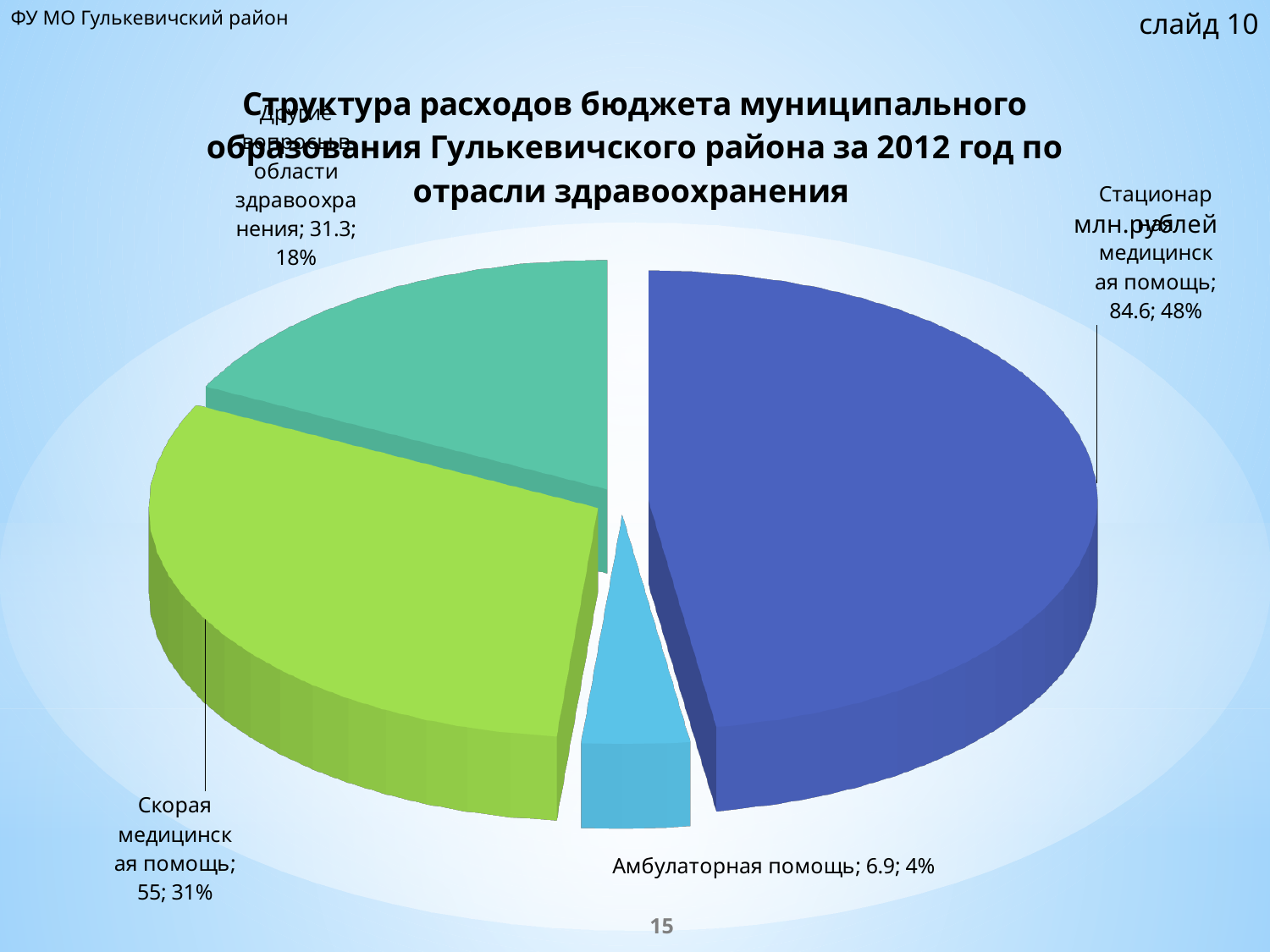
What is the value for Скорая медицинская помощь? 55 What is the value for Амбулаторная помощь? 6.9 Which category has the largest share of the pie? Стационарная медицинская помощь What percentage share of the pie does Другие вопросы в области здравоохранения have? 18% Which is larger: the value for Другие вопросы в области здравоохранения or the value for Амбулаторная помощь? Другие вопросы в области здравоохранения What is the difference between the values for Стационарная медицинская помощь and Скорая медицинская помощь? 29.6 What is the value for Стационарная медицинская помощь? 84.6 Which category has the smallest share of the pie? Амбулаторная помощь What kind of chart is shown on the slide? Pie chart What is the value for Другие вопросы в области здравоохранения? 31.3 How many slices does the pie chart have? 4 What percentage share of the pie does Скорая медицинская помощь have? 31%